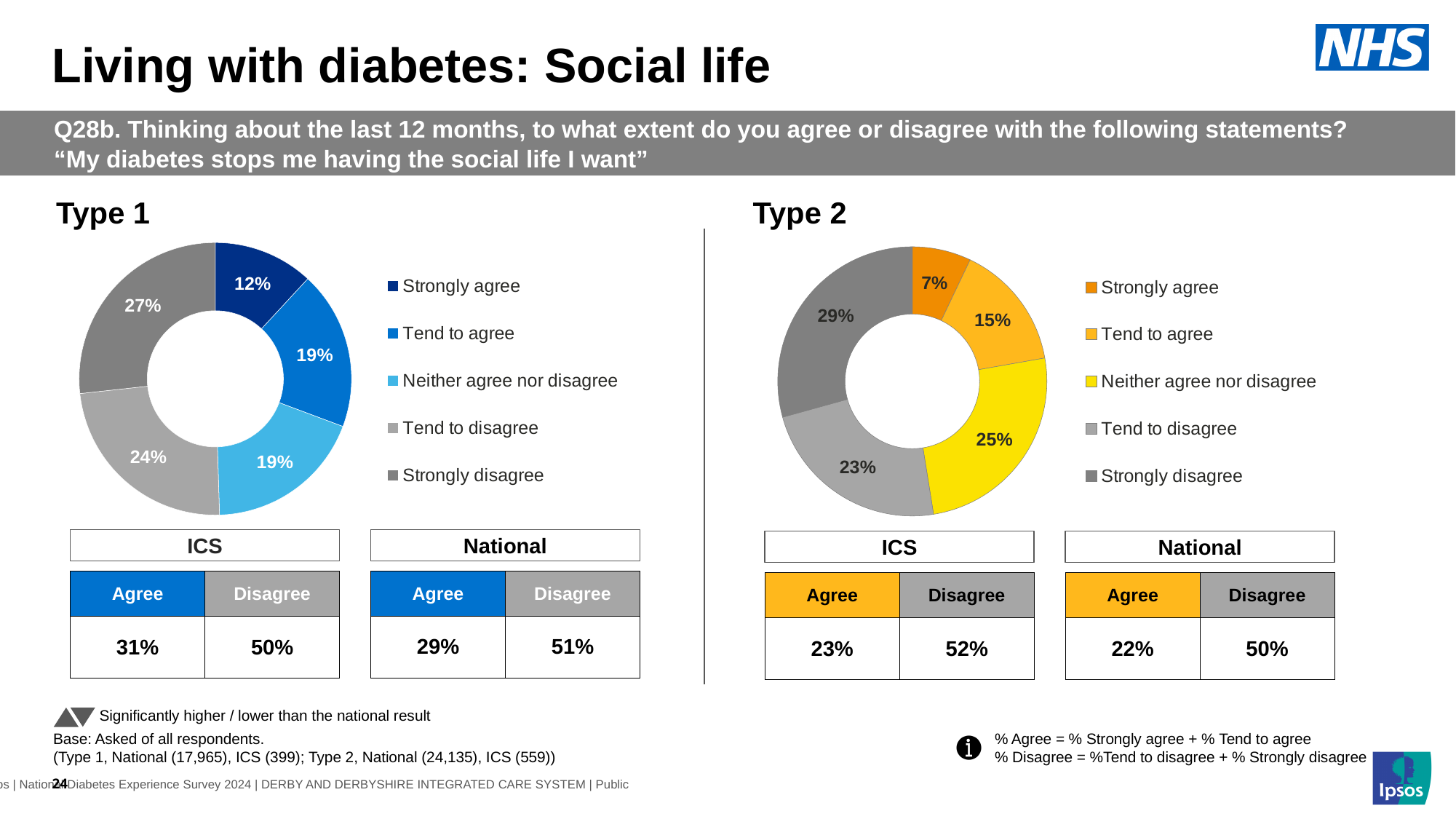
In the Type 2 chart, what is the combined share of 'Tend to disagree' and 'Strongly disagree'? 52% What type of chart is used for Type 2? Donut chart In the Type 1 chart, which response category has the largest share? Strongly disagree In the Type 1 chart, which is larger: 'Tend to disagree' or 'Strongly agree'? Tend to disagree In the Type 1 chart, what colour is the 'Strongly agree' segment? Dark blue In the Type 1 chart, what percentage of respondents said 'Strongly agree'? 12% How many entries does the legend of the Type 2 chart list? 5 In the Type 2 chart, what percentage of respondents said 'Neither agree nor disagree'? 25% In the Type 1 chart, what share of the pie is 'Tend to agree'? 19% In the Type 2 chart, which response category has the smallest share? Strongly agree In the Type 2 chart, what is the difference between the 'Strongly disagree' and 'Strongly agree' shares? 22% How many response categories are shown in the Type 1 chart? 5